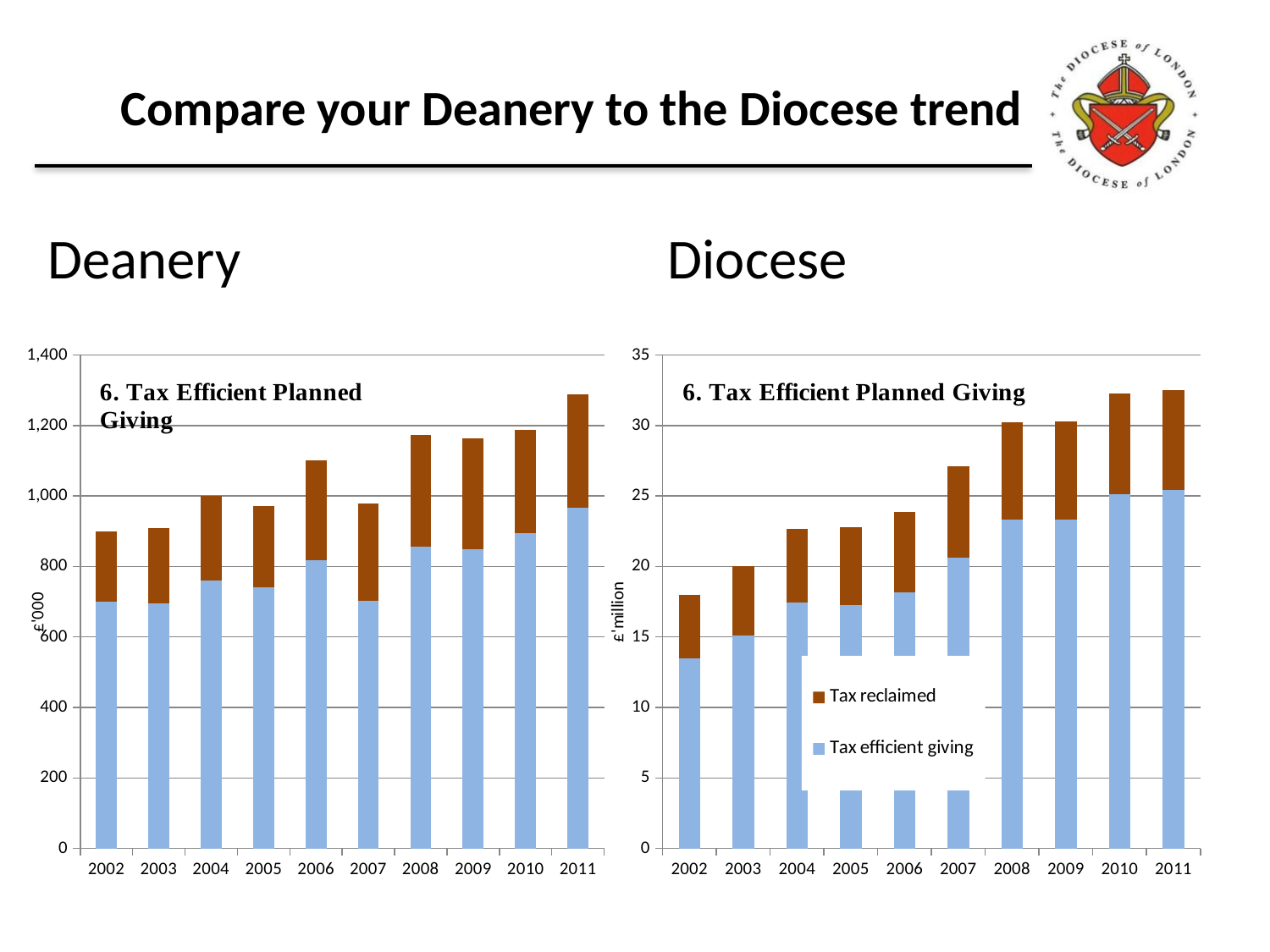
In the Diocese chart, is the total bar for 2002 greater or less than 20? less In the Deanery chart, which year has the tallest bar? 2011 How many series does the legend on the Diocese chart list? 2 In the Diocese chart, do the total bars generally rise or fall from 2002 to 2011? rise In the Deanery chart, which year has the taller bar, 2007 or 2008? 2008 In the Deanery chart, is the total bar for 2011 greater or less than 1,200? greater In the Deanery chart, is the total bar for 2002 greater or less than 1,000? less What is the y-axis label on the Diocese chart? £'million In the Diocese chart, which year has the shortest bar? 2002 How many years are shown on the x axis of the Diocese chart? 10 What kind of chart is the Deanery chart on the left? Stacked bar chart